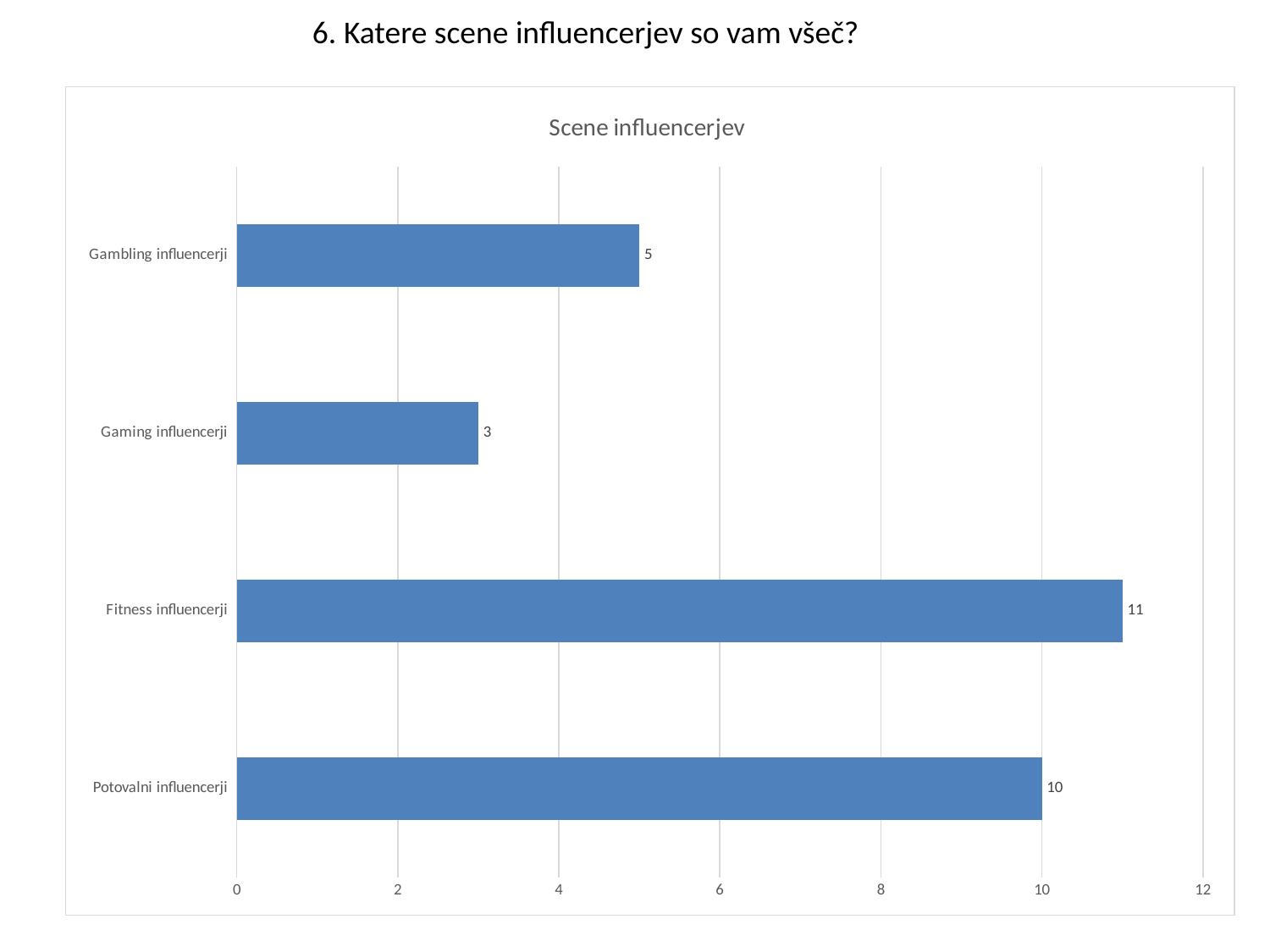
What is the value for Gambling influencerji? 5 How many categories are shown in the chart? 4 What is the value for Potovalni influencerji? 10 Which category has the lowest value? Gaming influencerji Is the value for Potovalni influencerji greater or less than 8? greater Which category has the highest value? Fitness influencerji What is the value for Fitness influencerji? 11 What is the difference between the values for Potovalni influencerji and Gambling influencerji? 5 Which is larger, the value for Gambling influencerji or the value for Gaming influencerji? Gambling influencerji What is the difference between the values for Fitness influencerji and Gaming influencerji? 8 What kind of chart is shown on the slide? bar chart What is the value for Gaming influencerji? 3